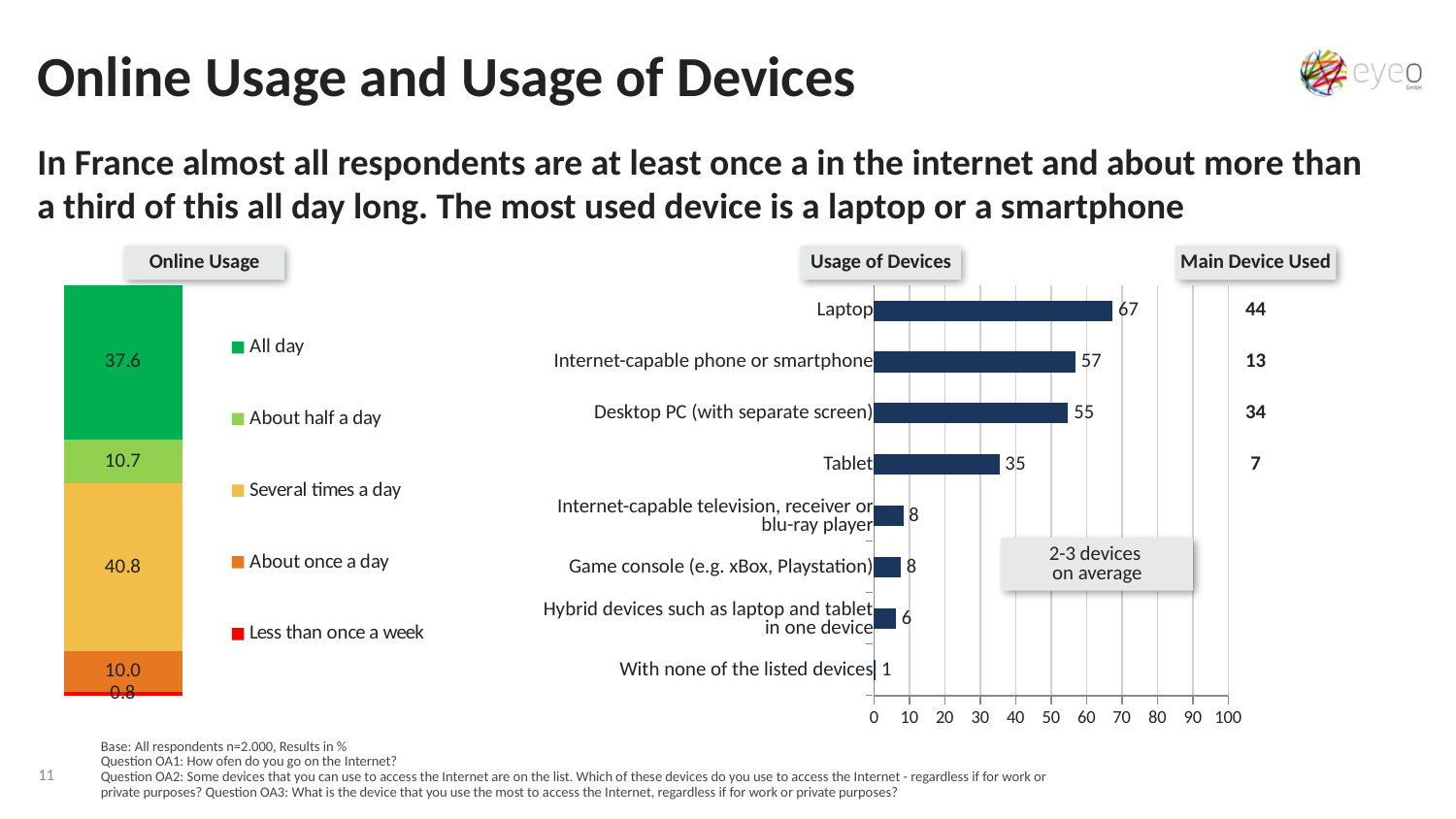
In the Online Usage chart, what is the value for All day? 37.6 In the Usage of Devices chart, which is larger: the value for Desktop PC (with separate screen) or the value for Tablet? Desktop PC (with separate screen) In the Usage of Devices chart, what is the value for Laptop? 67 How many device categories are shown in the Usage of Devices chart? 8 In the Online Usage chart, which category has the largest value? Several times a day How many categories does the legend of the Online Usage chart list? 5 In the Online Usage chart, what is the value for Several times a day? 40.8 What kind of chart is the Usage of Devices chart? Bar chart In the Usage of Devices chart, which device has the lowest value? With none of the listed devices In the Usage of Devices chart, what is the value for Tablet? 35 In the Usage of Devices chart, which device has the highest value? Laptop In the Usage of Devices chart, what is the difference between the values for Laptop and Internet-capable phone or smartphone? 10